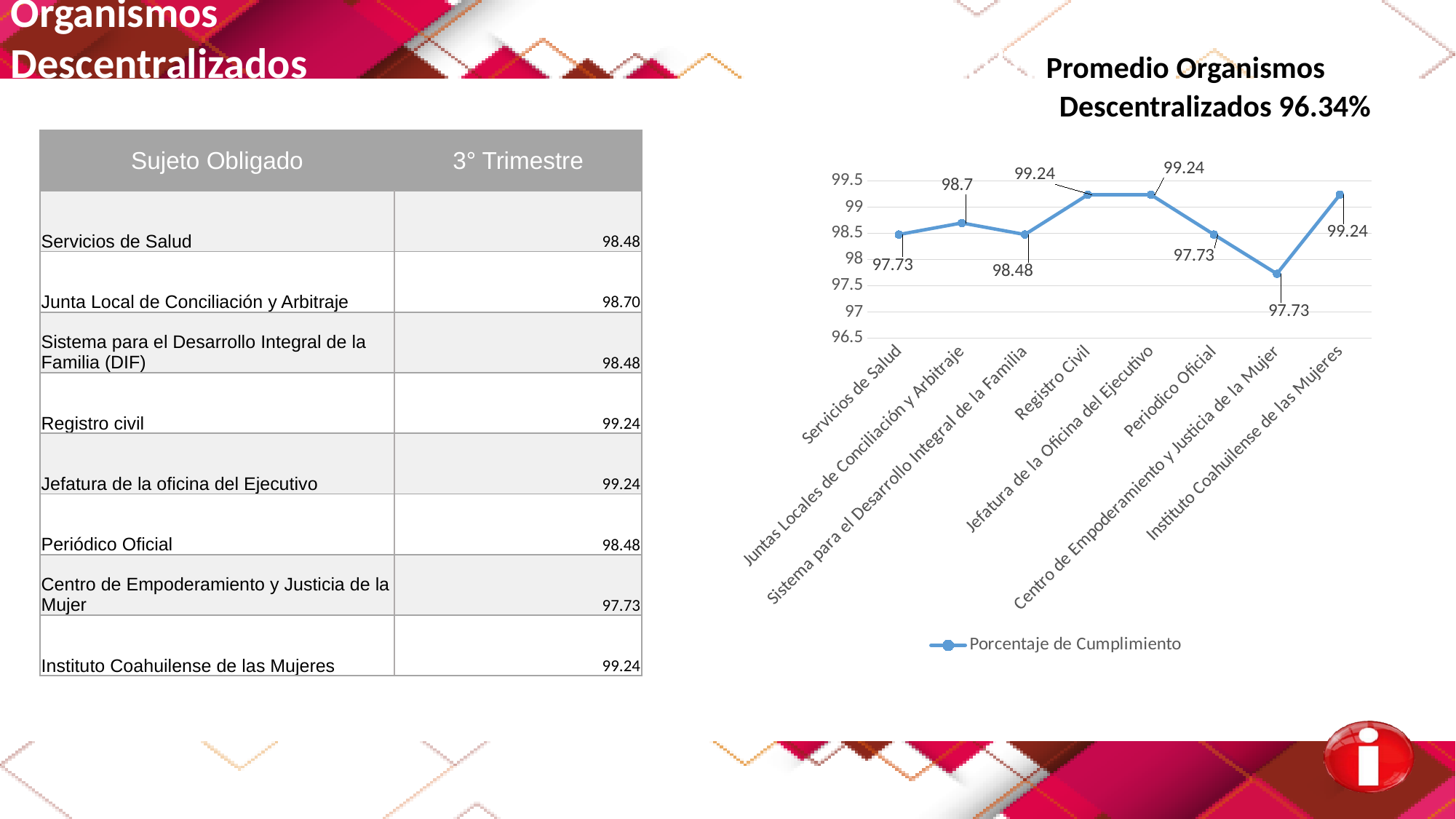
What type of chart is shown on the slide? Line chart Is the value for Periodico Oficial greater or less than 99? less What is the value for Juntas Locales de Conciliación y Arbitraje in the chart? 98.7 How many categories are plotted along the x axis of the chart? 8 Which category has the lowest value in the chart? Centro de Empoderamiento y Justicia de la Mujer What is the value for Instituto Coahuilense de las Mujeres in the chart? 99.24 Which has the larger value, Registro Civil or Centro de Empoderamiento y Justicia de la Mujer? Registro Civil What is the value for Registro Civil in the chart? 99.24 What is the name of the series shown in the chart legend? Porcentaje de Cumplimiento What is the value for Centro de Empoderamiento y Justicia de la Mujer in the chart? 97.73 What is the difference between the values for Registro Civil and Centro de Empoderamiento y Justicia de la Mujer? 1.51 How many series does the chart legend list? 1